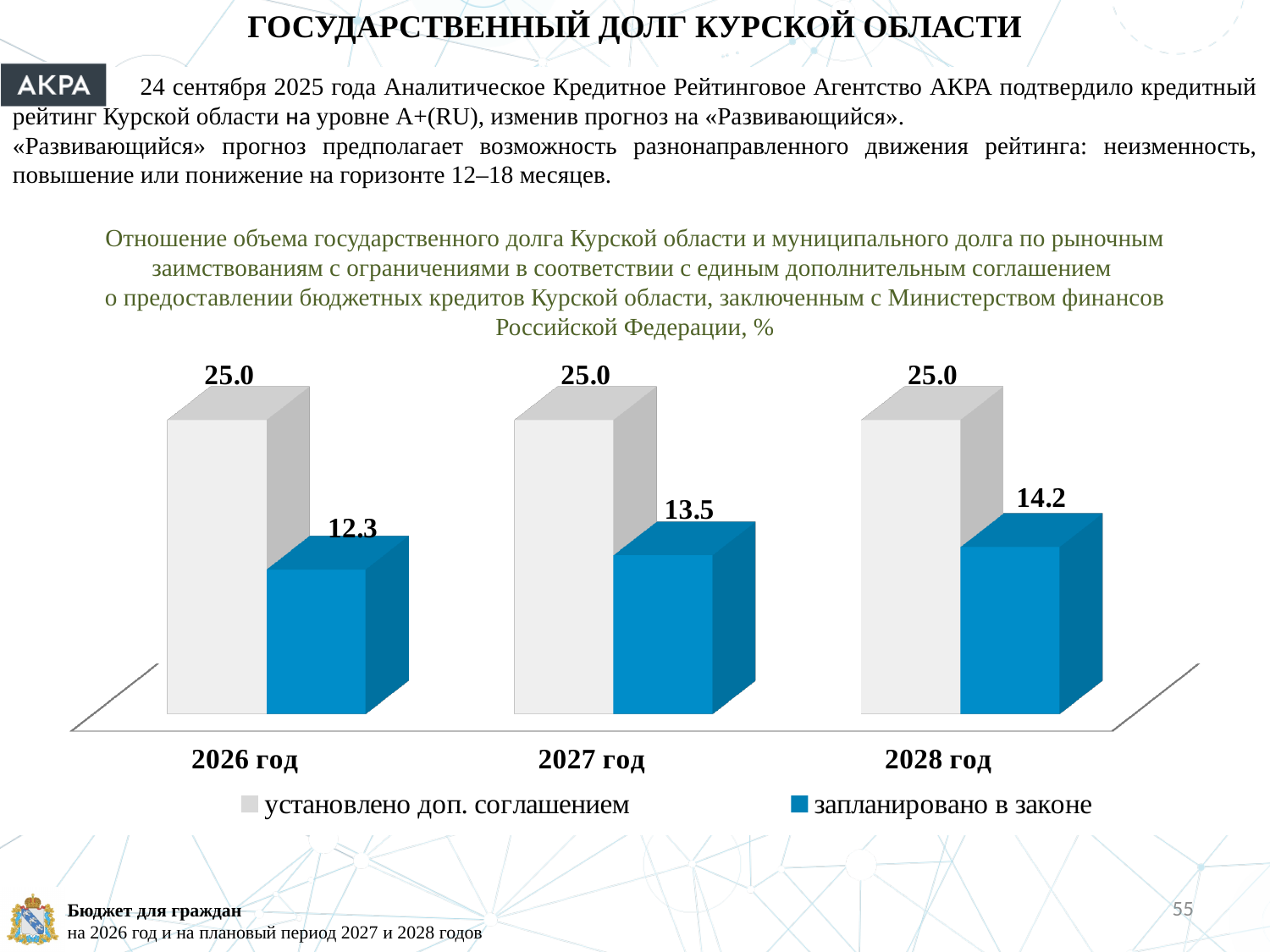
How many series does the legend list? 2 Which is larger in 2027 год: 'установлено доп. соглашением' or 'запланировано в законе'? установлено доп. соглашением What is the difference between the 'запланировано в законе' values for 2028 год and 2027 год? 0.7 How many years are shown on the x axis of the chart? 3 What is the value for 'запланировано в законе' in 2028 год? 14.2 In which year is the value for 'запланировано в законе' the lowest? 2026 год In which year is the value for 'запланировано в законе' the highest? 2028 год Does the value for 'запланировано в законе' rise or fall from 2026 год to 2028 год? rise What is the value for 'запланировано в законе' in 2027 год? 13.5 What is the value for 'запланировано в законе' in 2026 год? 12.3 What is the difference between 'установлено доп. соглашением' and 'запланировано в законе' in 2026 год? 12.7 What is the value for 'установлено доп. соглашением' in 2027 год? 25.0